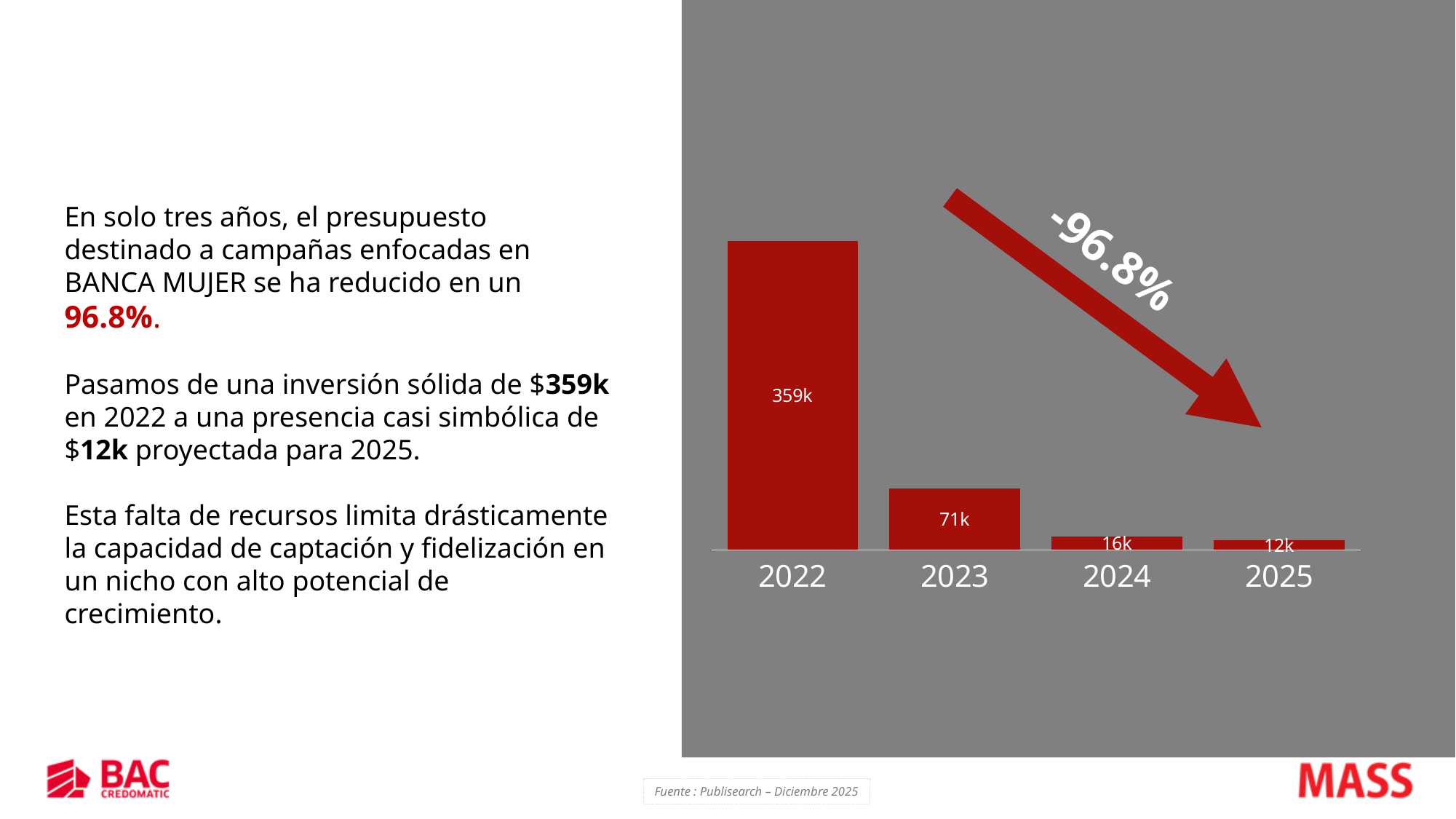
Which year has the lowest value? 2025 Do the values rise or fall from 2022 to 2025? Fall What is the value shown for 2023? 71k Which year has the highest value? 2022 What is the value shown for 2025? 12k How many years are shown on the chart? 4 What is the value shown for 2022? 359k What is the value shown for 2024? 16k What kind of chart is shown? Bar chart What is the difference between the values for 2022 and 2023? 288k What is the difference between the values for 2024 and 2025? 4k Which is larger, the value for 2023 or the value for 2024? 2023